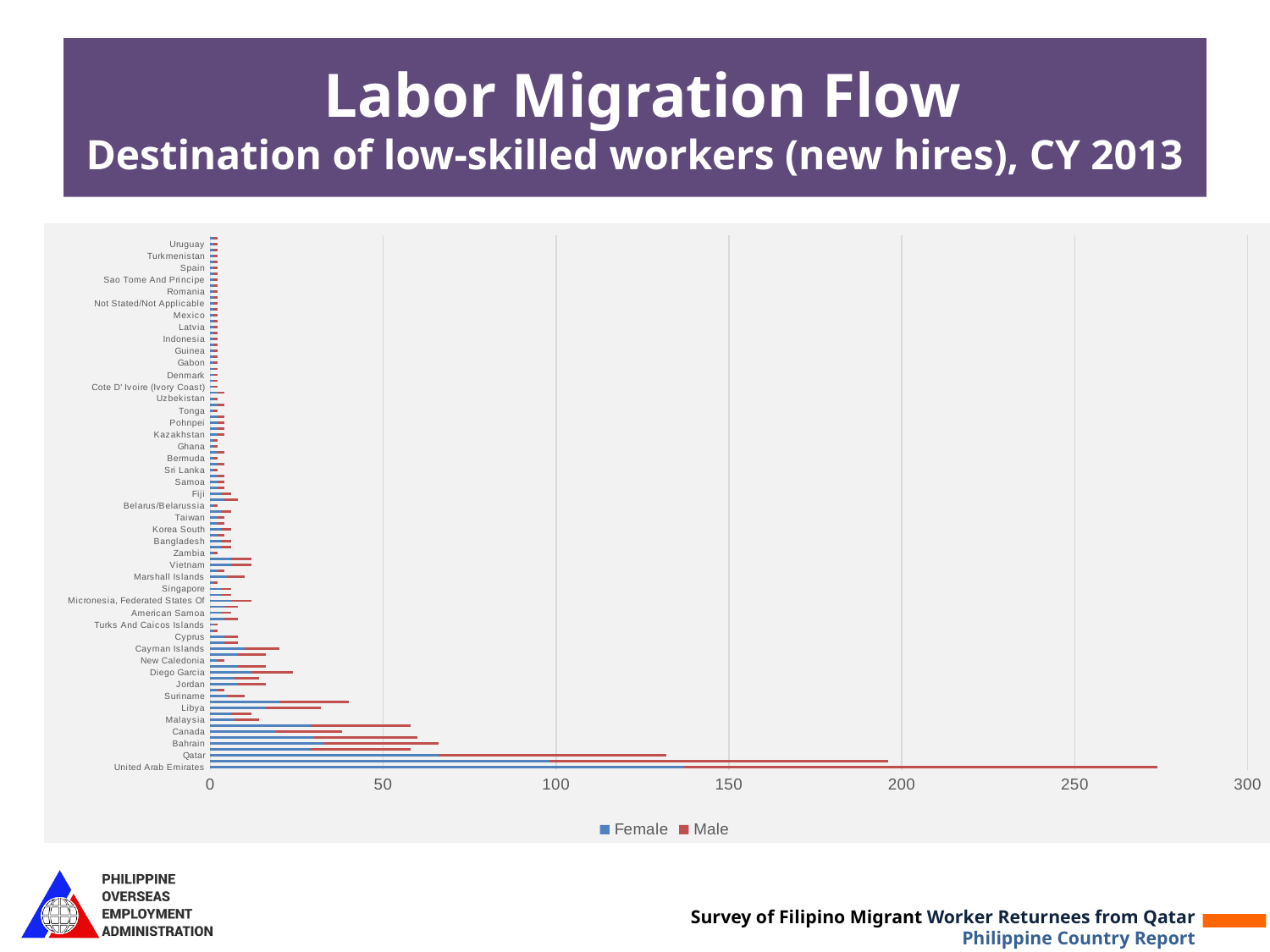
How many series does the legend list? 2 Is the Female value for United Arab Emirates greater or less than 100? greater Is the Male value for United Arab Emirates greater or less than 250? less Which category has the highest Female value? United Arab Emirates Which is larger, the Male value for Qatar or the Male value for Bahrain? Qatar Is the Female value for Malaysia greater or less than 50? less What kind of chart is shown on the slide? bar chart For United Arab Emirates, which is larger, the Female value or the Male value? They are equal Which category has the highest Male value? United Arab Emirates Which colour represents the Female series in the legend? blue